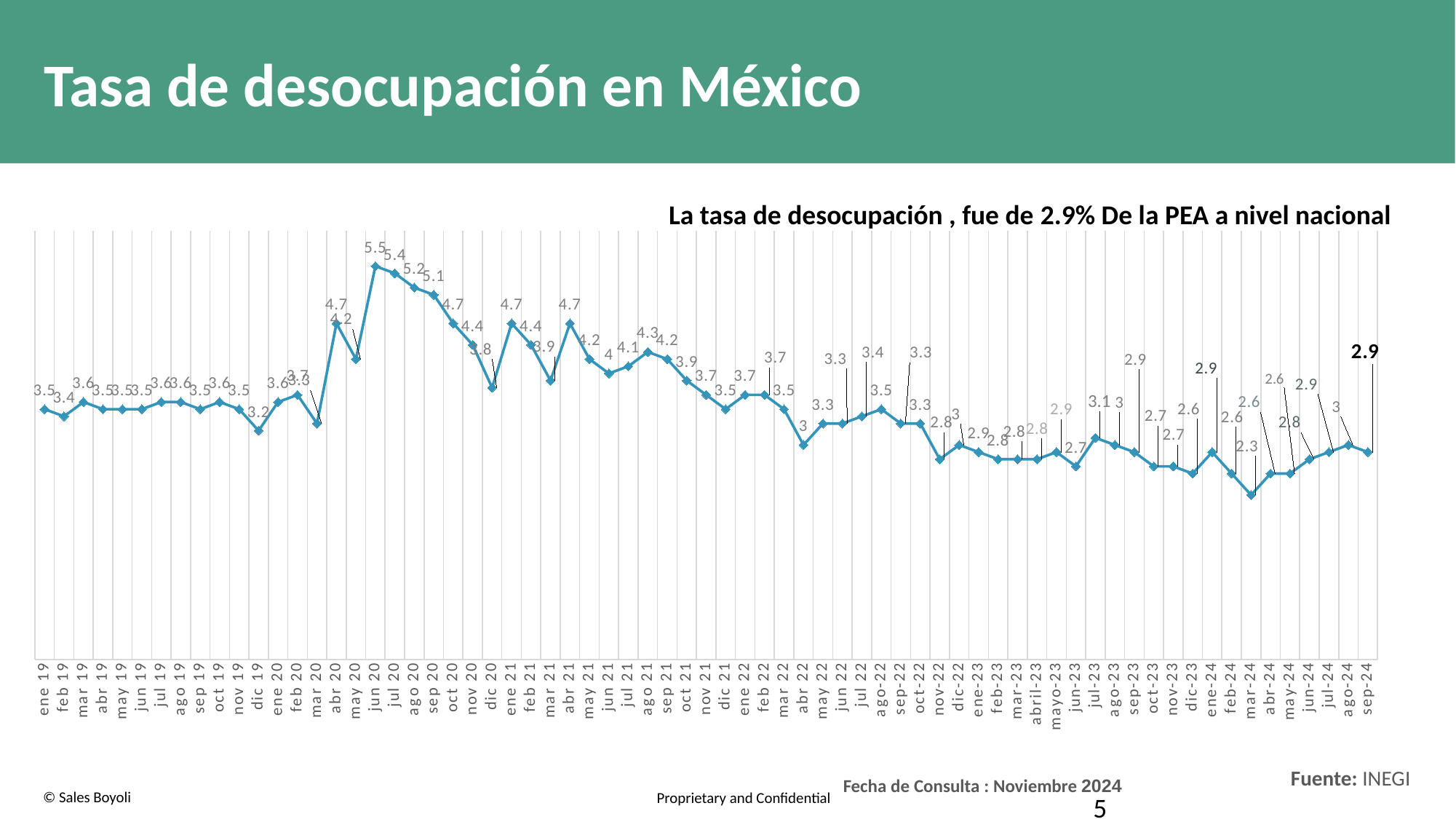
Which is larger, the value for abr 20 or the value for may 20? abr 20 What is the unemployment rate shown for sep-24? 2.9 What value is plotted for jun 20? 5.5 Which month has the highest unemployment rate on the chart? jun 20 What value is plotted for mar-24? 2.3 What kind of chart is shown on the slide? Line chart Do the values rise or fall from jun 20 to dic 20? Fall What value is plotted for dic 19? 3.2 How many monthly data points are plotted on the chart? 69 What is the difference between the value for jun 20 and the value for sep-24? 2.6 Which month has the lowest unemployment rate on the chart? mar-24 What is the title of the slide containing the chart? Tasa de desocupación en México